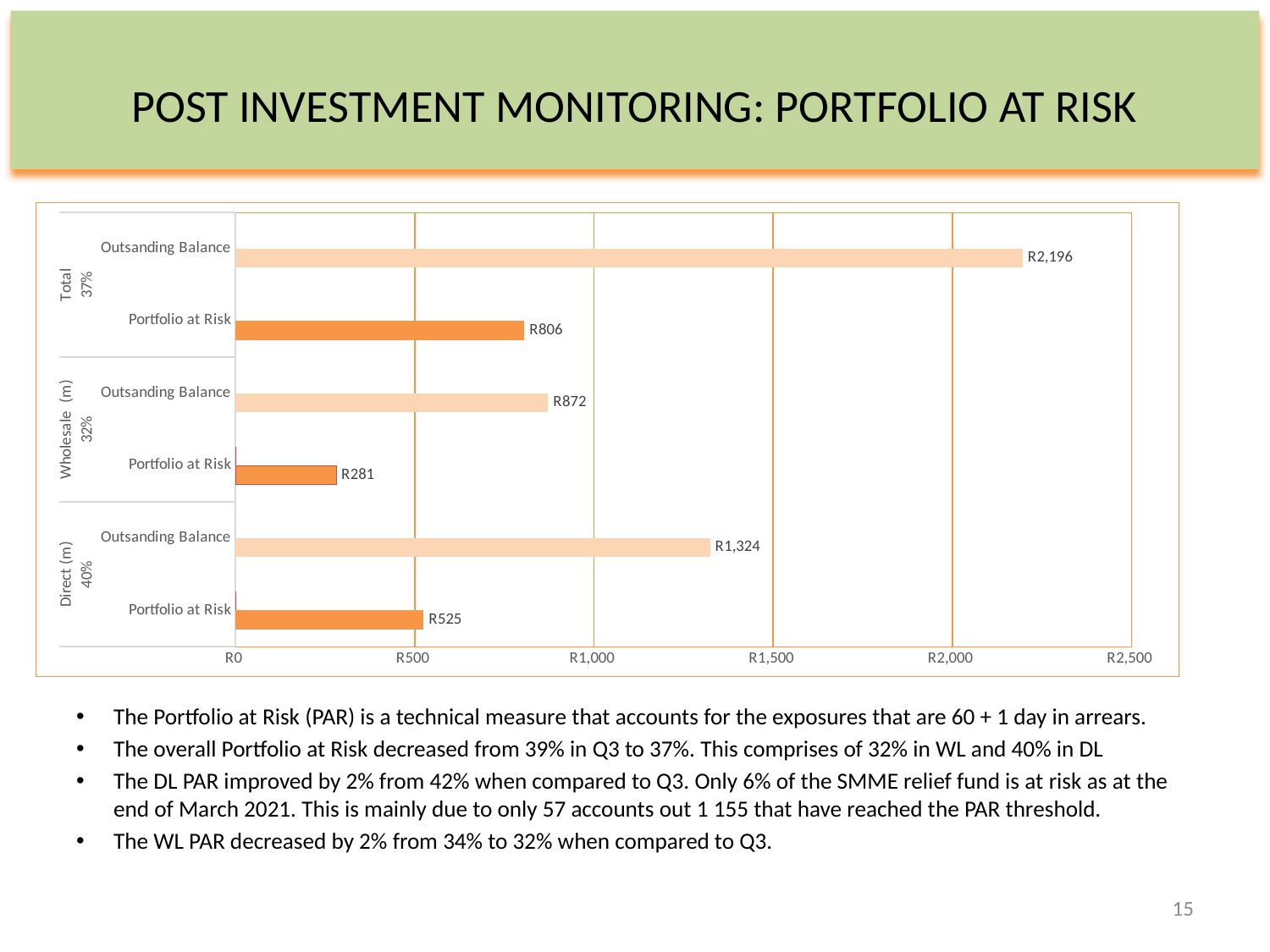
How many bars are plotted on the chart? 6 Which is larger: the Outstanding Balance for Wholesale (m) or the Outstanding Balance for Direct (m)? Direct (m) What is the Portfolio at Risk value for Direct (m)? R525 What is the Outstanding Balance for Direct (m)? R1,324 Which bar has the highest value on the chart? Total Outstanding Balance What percentage is shown next to the Wholesale (m) group label on the chart's axis? 32% What is the difference between the Direct (m) Portfolio at Risk and the Wholesale (m) Portfolio at Risk? R244 What type of chart is shown on the slide? Bar chart What is the difference between the Outstanding Balance and the Portfolio at Risk for Wholesale (m)? R591 What is the Outstanding Balance for Total? R2,196 What is the Portfolio at Risk value for Wholesale (m)? R281 Which bar has the lowest value on the chart? Wholesale (m) Portfolio at Risk